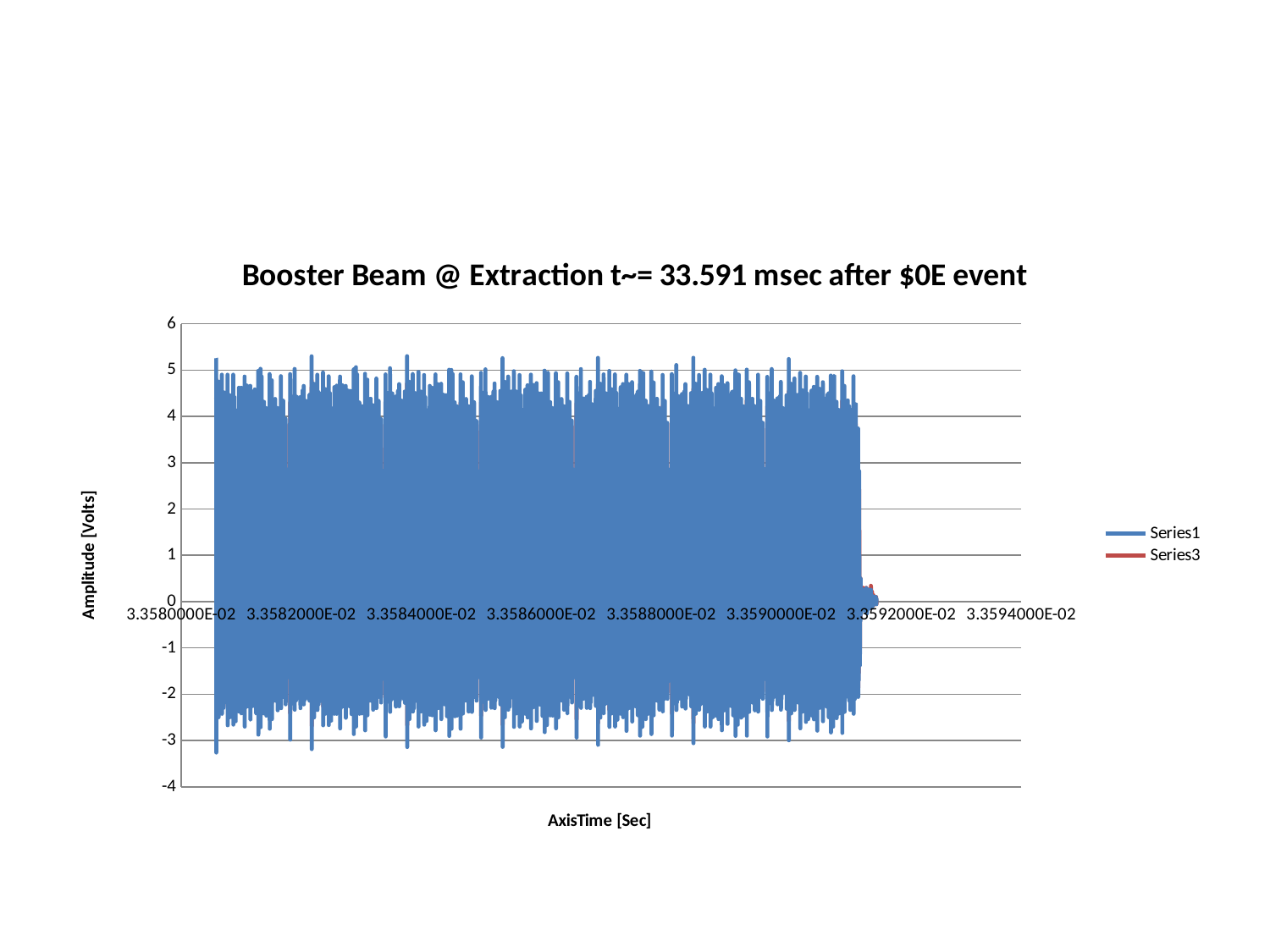
Is the highest value reached by Series1 greater or less than 5? greater Is the lowest value reached by Series1 greater or less than -3? less How many series does the legend list? 2 What kind of chart is shown on the slide? line chart Toward the right end of the x axis, does the amplitude of Series1 increase or decrease? decrease What is the title of the chart? Booster Beam @ Extraction t~= 33.591 msec after $0E event What are the two entries in the chart legend? Series1 and Series3